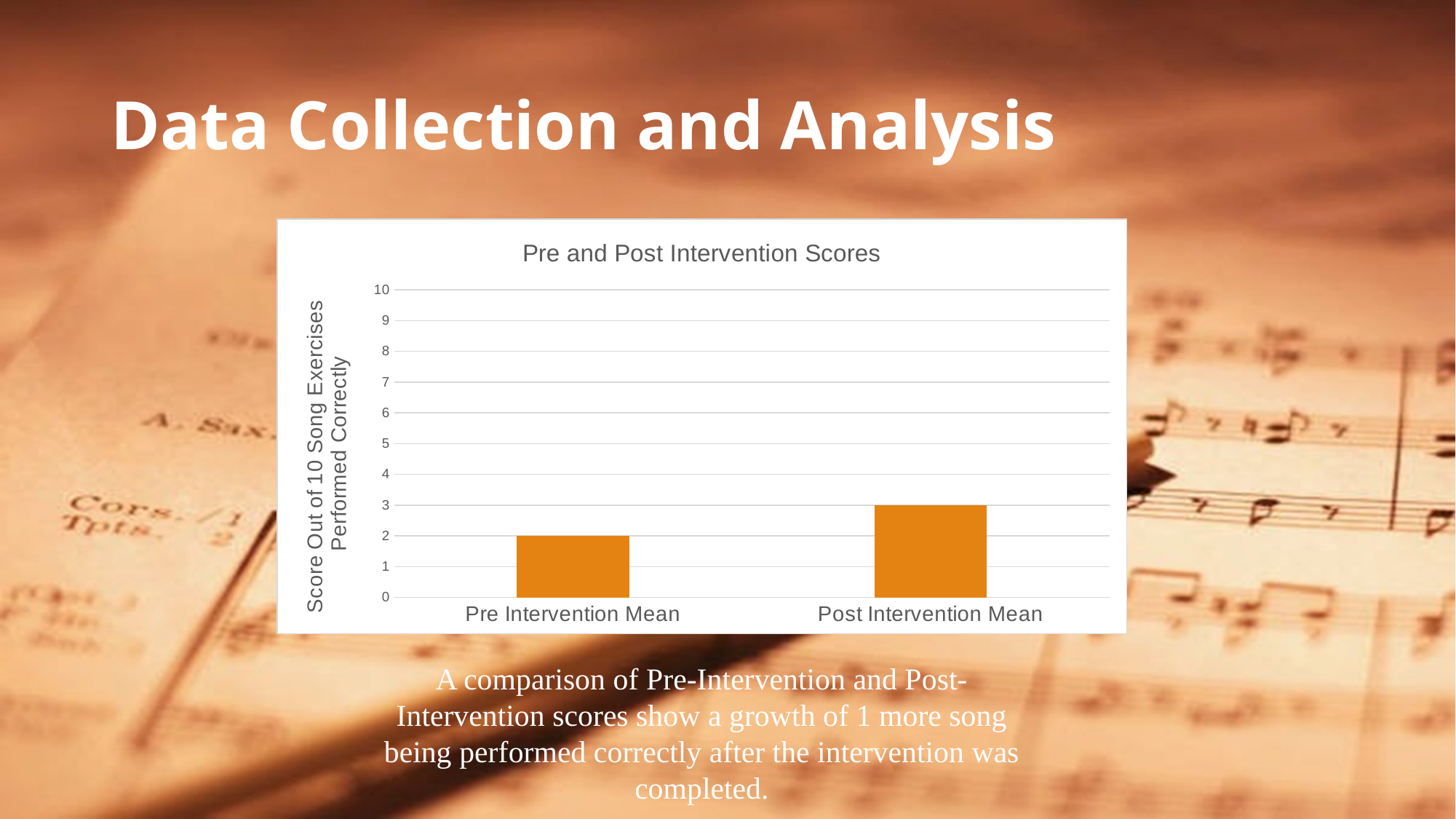
How many categories are shown on the x axis? 2 What is the value for Pre Intervention Mean? 2 Do the values rise or fall from Pre Intervention Mean to Post Intervention Mean? rise What is the value for Post Intervention Mean? 3 Which category has the lowest value? Pre Intervention Mean What is the label of the vertical axis? Score Out of 10 Song Exercises Performed Correctly What type of chart is shown on the slide? bar chart What is the difference between the Post Intervention Mean and the Pre Intervention Mean? 1 Which is larger, the Pre Intervention Mean or the Post Intervention Mean? Post Intervention Mean What is the title of the chart? Pre and Post Intervention Scores Which category has the highest value? Post Intervention Mean Is the value for Post Intervention Mean greater or less than 5? less